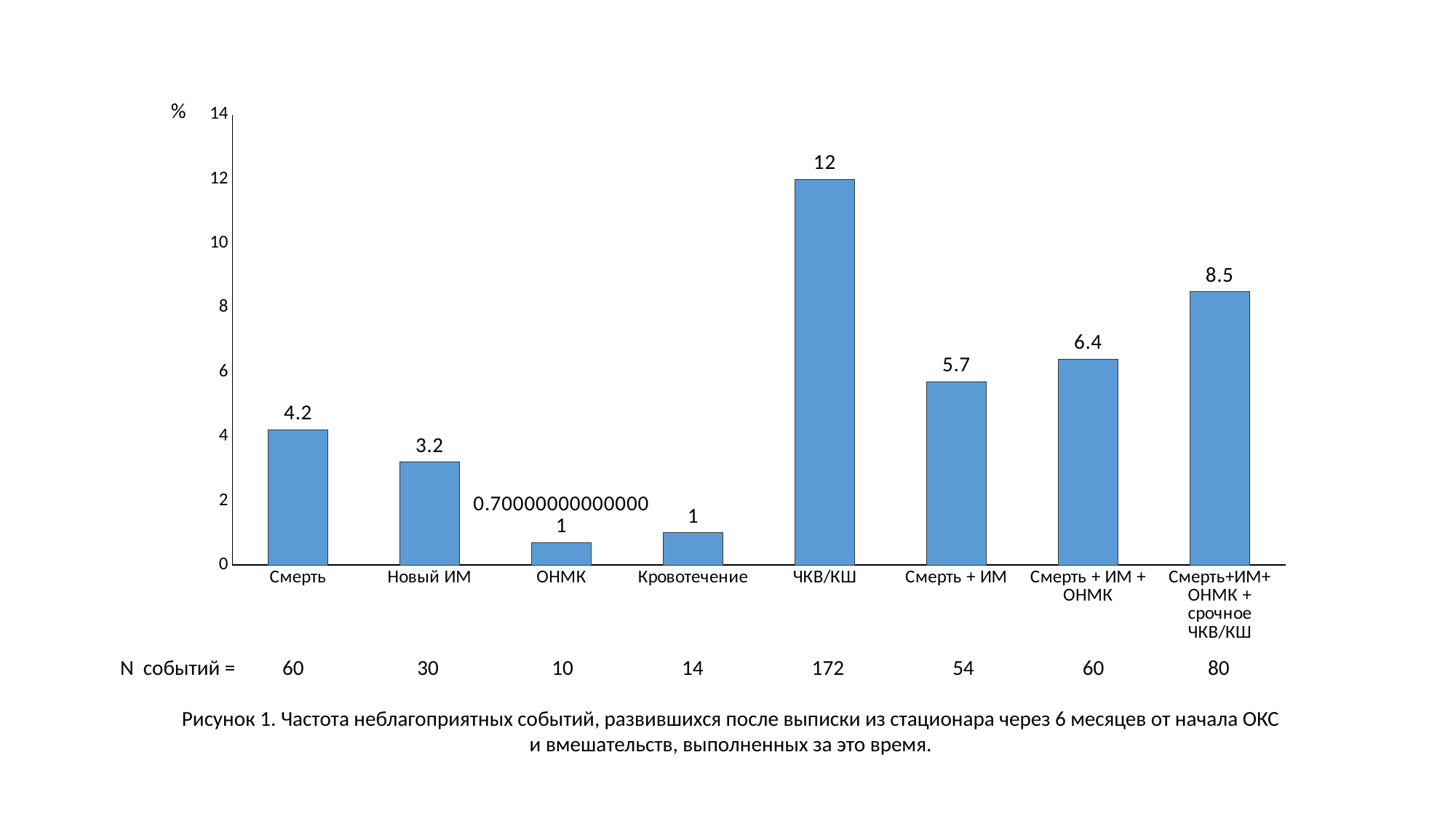
What type of chart is shown on the slide? bar chart Which is larger, the value for Смерть + ИМ or the value for Смерть+ИМ+ОНМК + срочное ЧКВ/КШ? Смерть+ИМ+ОНМК + срочное ЧКВ/КШ What is the value for Новый ИМ? 3.2 What is the value for ЧКВ/КШ? 12 Which category has the highest value? ЧКВ/КШ What unit is shown on the y axis? % Is the value for ОНМК greater or less than 2? less How many categories are plotted on the x axis? 8 What is the value for Смерть + ИМ + ОНМК? 6.4 Which category has the lowest value? ОНМК What is the value for Смерть? 4.2 What is the difference between the values for ЧКВ/КШ and Смерть? 7.8